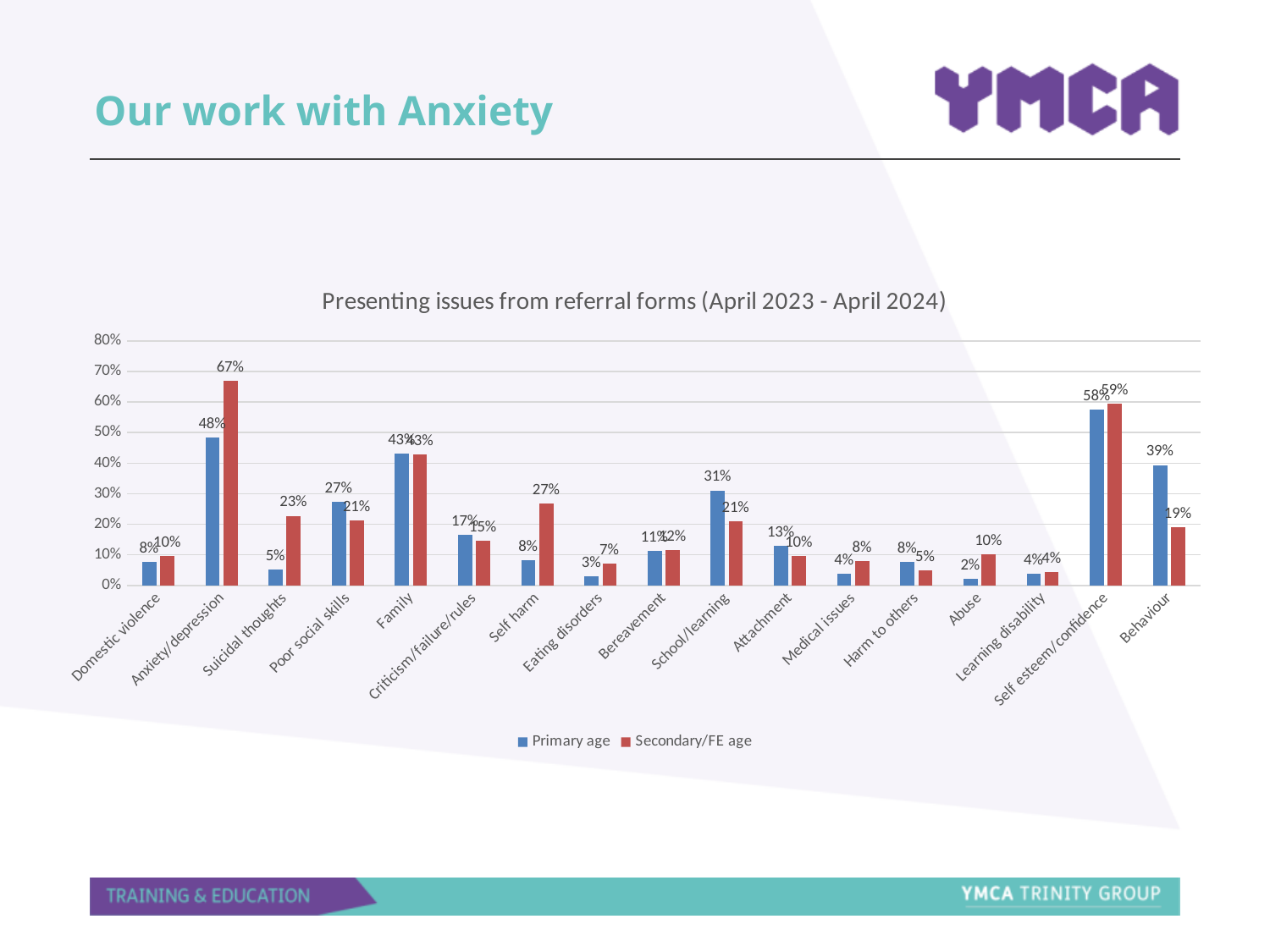
Which category has the lowest Primary age value? Abuse For School/learning, which is larger: the Primary age value or the Secondary/FE age value? Primary age How many categories are shown on the x axis? 17 What is the title of the chart? Presenting issues from referral forms (April 2023 - April 2024) What is the difference between the Secondary/FE age and Primary age values for Behaviour? 20% Which category has the highest Secondary/FE age value? Anxiety/depression What is the Primary age value for Anxiety/depression? 48% What type of chart is shown on the slide? Bar chart How many series does the legend list? 2 What is the difference between the Secondary/FE age and Primary age values for Suicidal thoughts? 18% Which series is shown in red? Secondary/FE age What is the Secondary/FE age value for Self harm? 27%